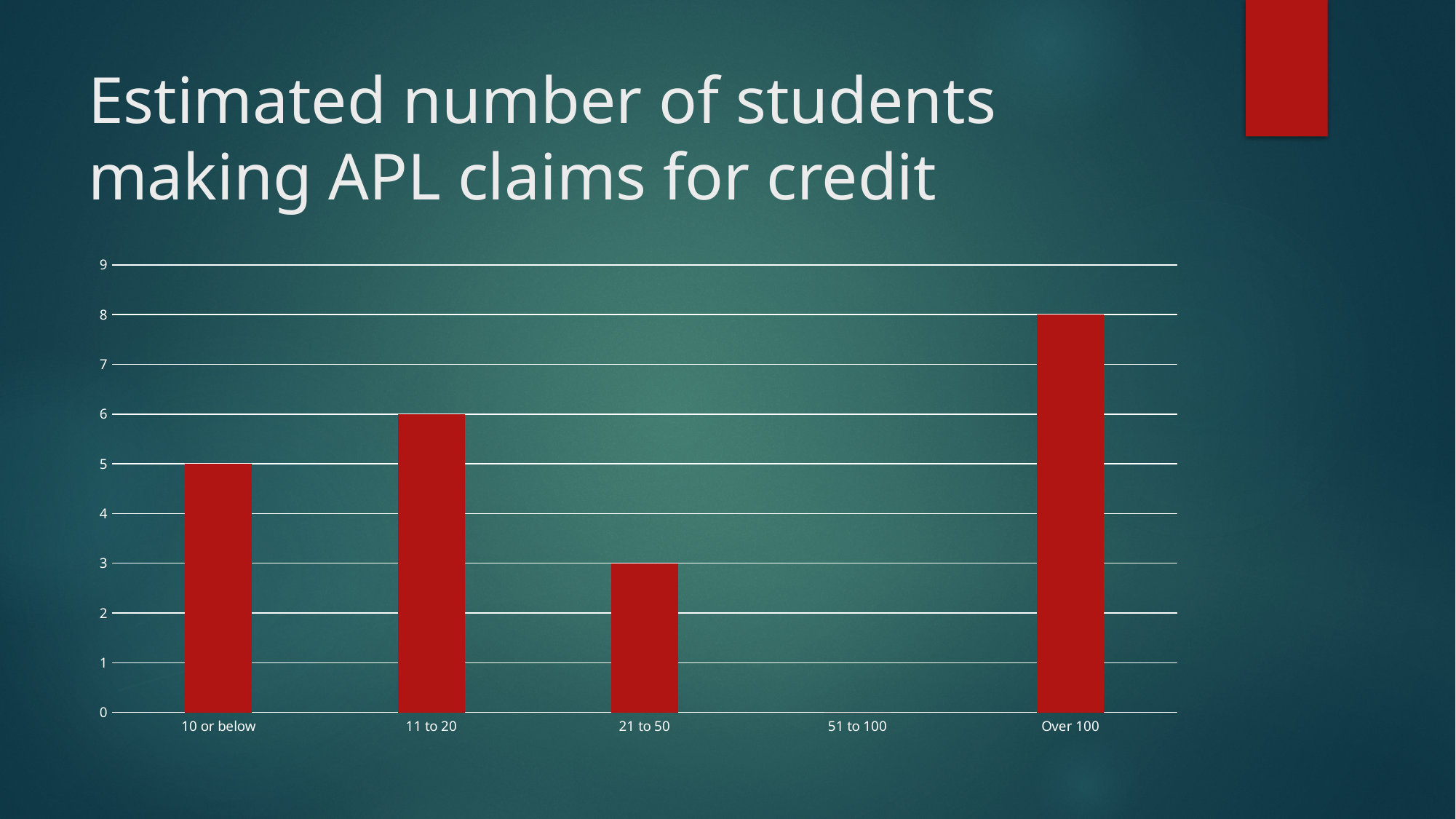
What is the value for the '10 or below' category? 5 What is the value for the '11 to 20' category? 6 What is the difference between the values for '11 to 20' and '10 or below'? 1 How many categories are shown on the x axis? 5 Is the value for 'Over 100' greater or less than 7? greater Which is larger, the value for '11 to 20' or the value for '21 to 50'? 11 to 20 What is the value for the '21 to 50' category? 3 What is the value for the 'Over 100' category? 8 What kind of chart is shown on the slide? bar chart What is the difference between the values for 'Over 100' and '21 to 50'? 5 What is the title of the slide containing the chart? Estimated number of students making APL claims for credit Which category has the highest value? Over 100